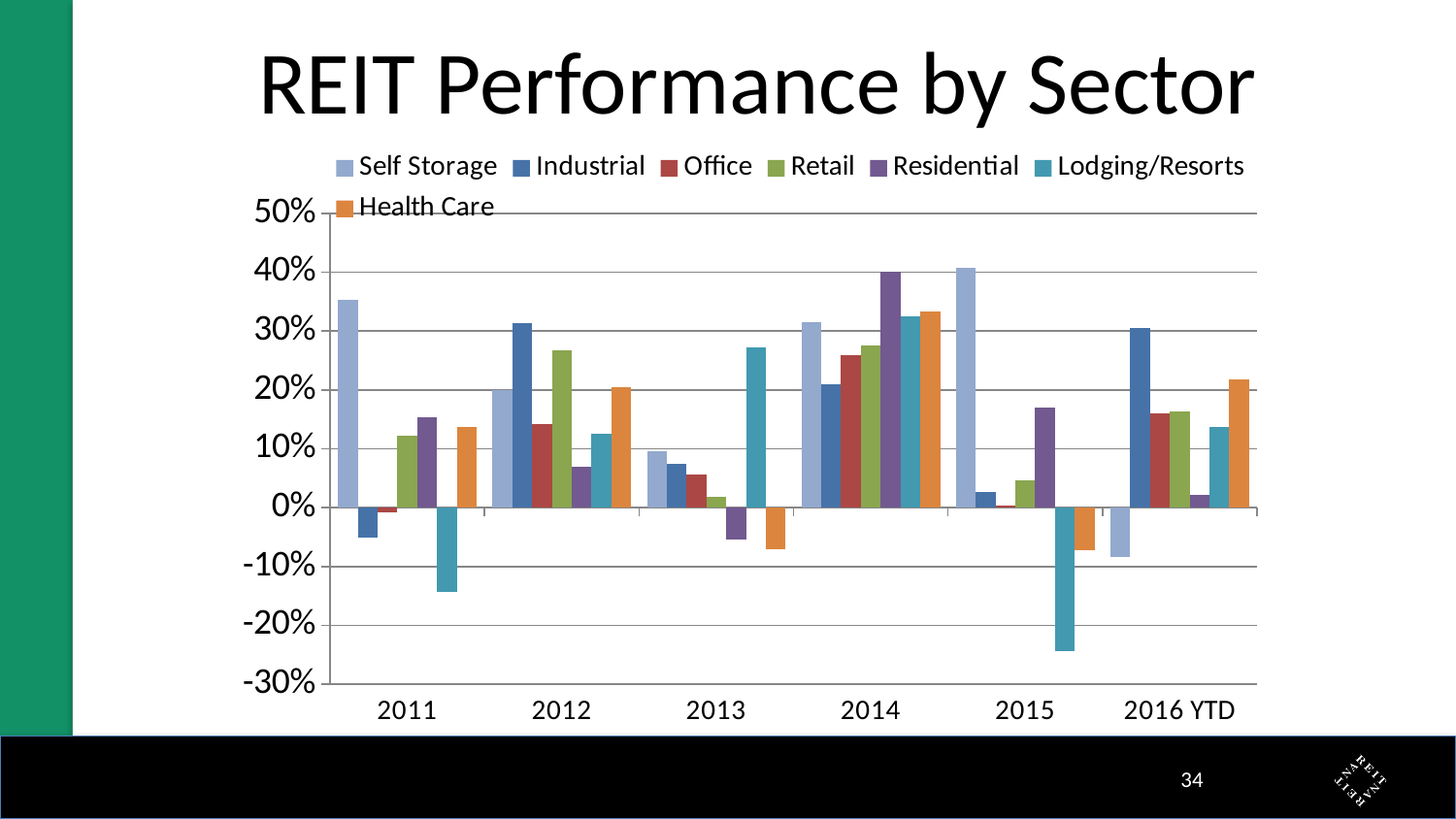
How many sectors does the legend list? 7 What kind of chart is shown on the slide? bar chart Is the value for Self Storage in 2011 greater or less than 30%? greater In 2016 YTD, which is larger: Industrial or Health Care? Industrial Which sector has the lowest value in 2016 YTD? Self Storage Which sector has the lowest value in 2011? Lodging/Resorts How many year categories are shown on the x axis? 6 Is the value for Lodging/Resorts in 2015 greater or less than -20%? less Which sector has the highest value in 2014? Residential What is the title of the chart? REIT Performance by Sector Which sector has the highest value in 2015? Self Storage Is the value for Residential in 2014 greater or less than 30%? greater